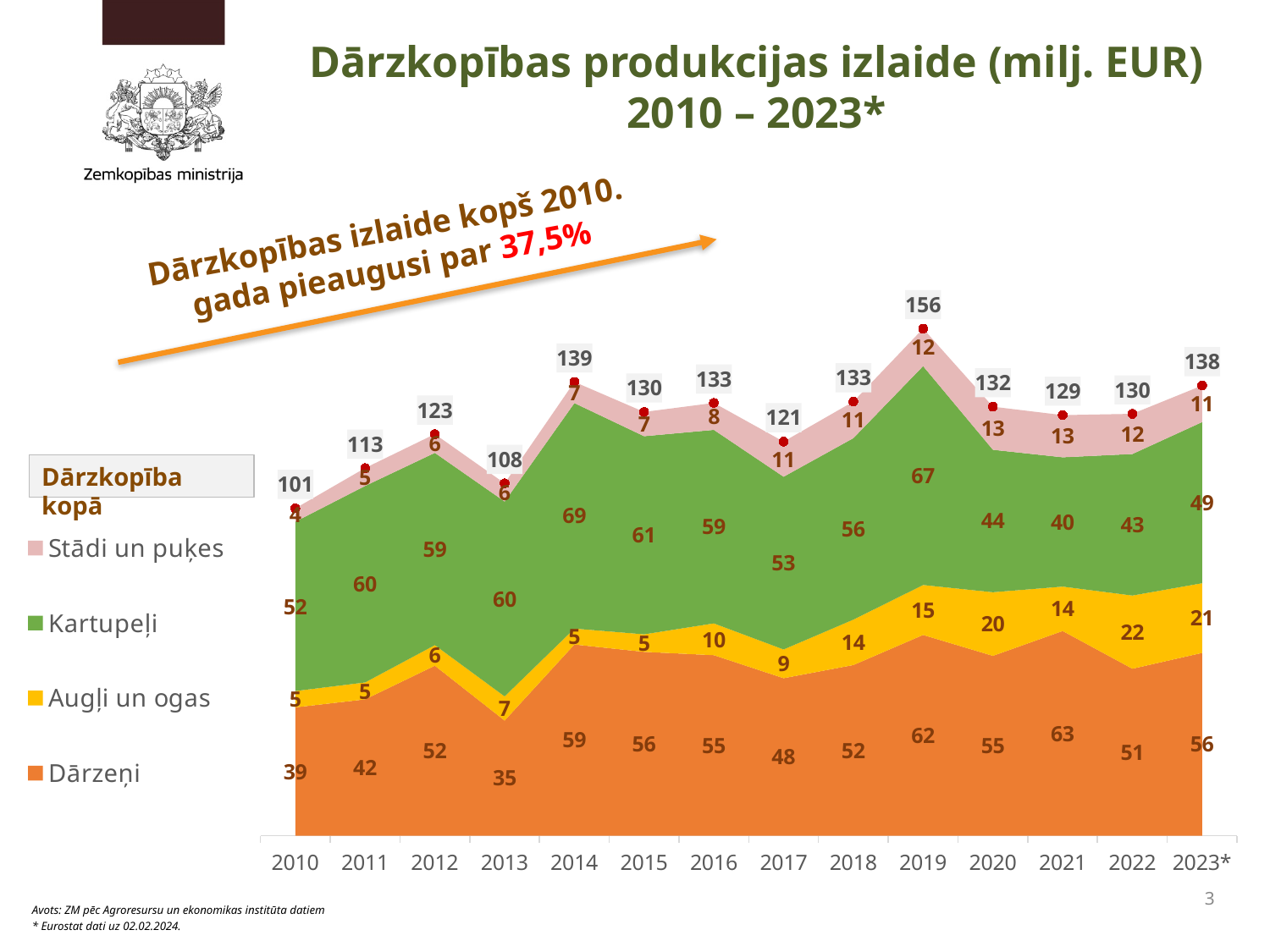
By how much did the total horticultural output change from 2010 to 2023*? 37 What is the value for Stādi un puķes in 2010? 4 In which year was the total horticultural output (Dārzkopība kopā) highest? 2019 What is the value for Kartupeļi in 2014? 69 In which year was the total horticultural output (Dārzkopība kopā) lowest? 2010 Which is larger, the Kartupeļi value in 2019 or in 2020? 2019 What kind of chart is shown on the slide? Stacked area chart What is the value for Augļi un ogas in 2022? 22 What was the total horticultural output (Dārzkopība kopā) in 2019? 156 What is the title of the chart? Dārzkopības produkcijas izlaide (milj. EUR) 2010 – 2023* How many years are shown on the x axis? 14 What is the value for Dārzeņi in 2021? 63